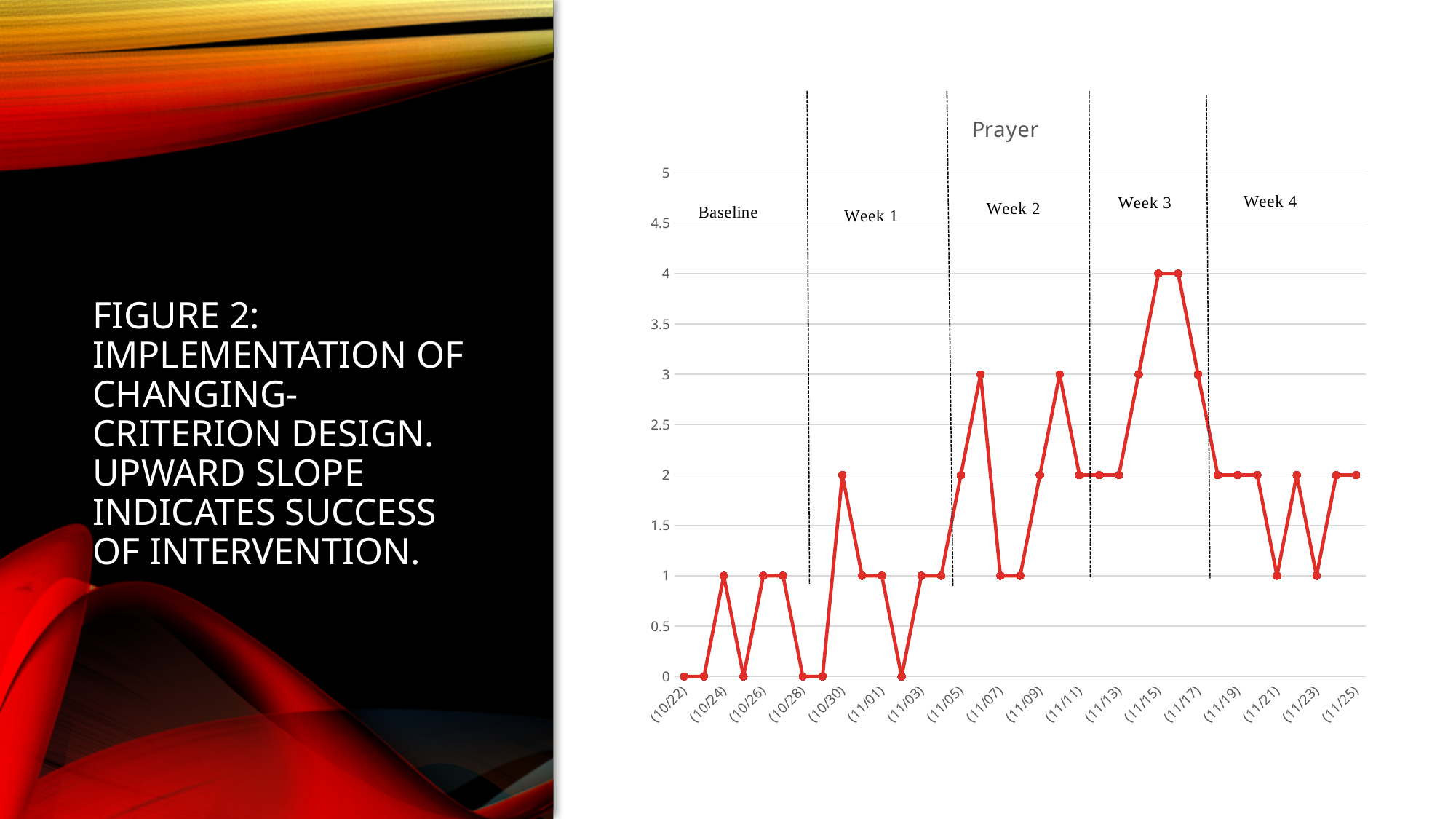
What is the lowest value shown on the chart? 0 What is the value plotted for (10/30)? 2 What is the value plotted for (10/28)? 0 Overall, do the values rise or fall from the Baseline phase to Week 3? rise What is the value plotted for (11/17)? 3 What is the highest value reached on the chart? 4 What is the value plotted for (11/15)? 4 What is the title of the chart? Prayer How many phase labels (Baseline and Weeks) are marked on the chart? 5 What type of chart is shown on the slide? line chart Which has the larger value, (11/17) or (11/23)? (11/17) What is the difference between the values for (11/15) and (11/21)? 3